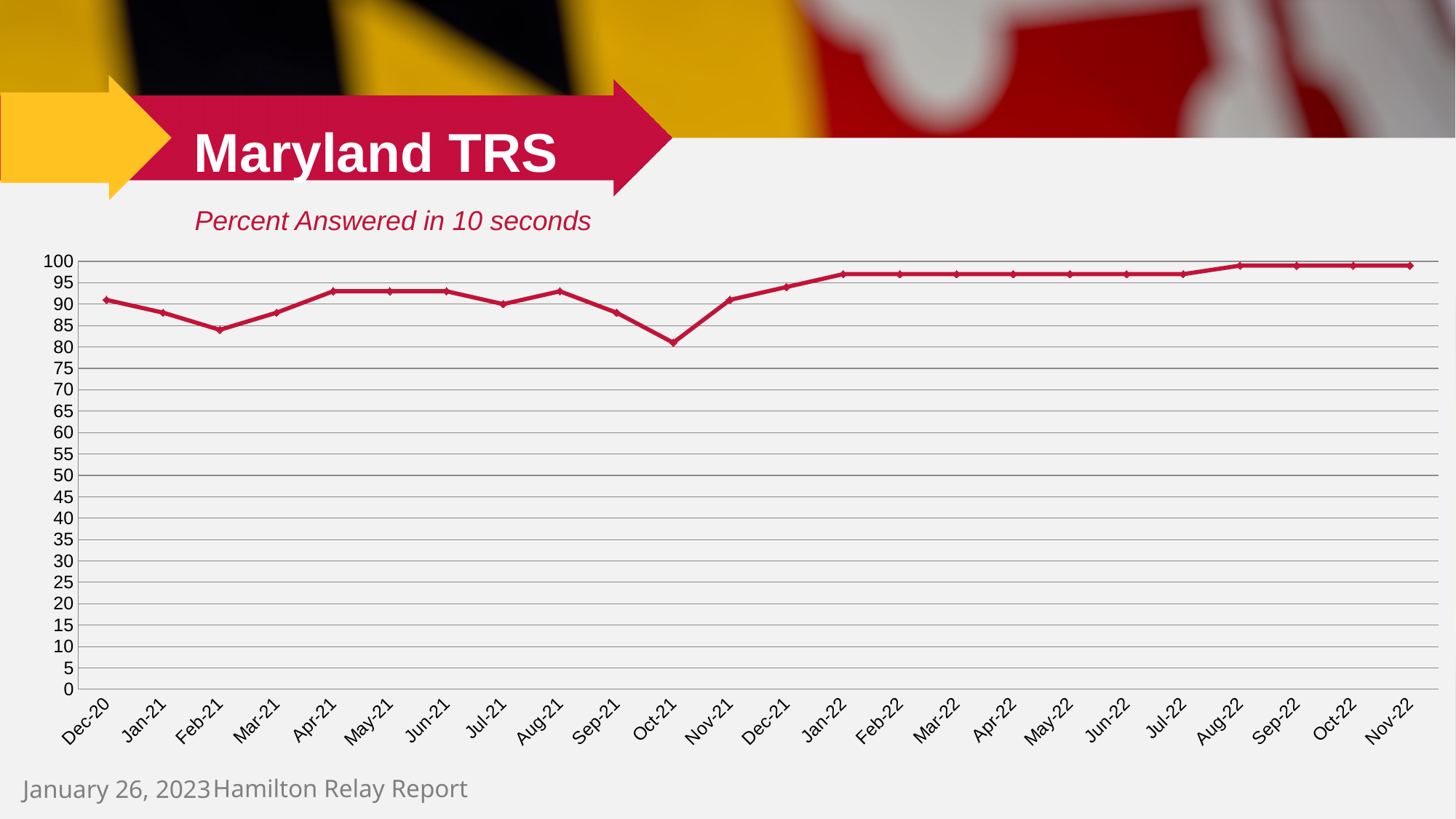
What kind of chart is shown on the slide? line chart What is the highest value shown on the y axis? 100 What is the title of the chart? Percent Answered in 10 seconds Is the value for Jan-22 greater or less than 95? greater Which is larger, the value for Oct-21 or the value for Nov-21? Nov-21 Is the value for Feb-21 greater or less than 80? greater Is the value for Apr-21 greater or less than 90? greater How many months are plotted along the x axis? 24 Do the values rise or fall from Oct-21 to Jan-22? rise Which is larger, the value for Feb-21 or the value for Apr-21? Apr-21 Which month has the lowest percent answered in 10 seconds? Oct-21